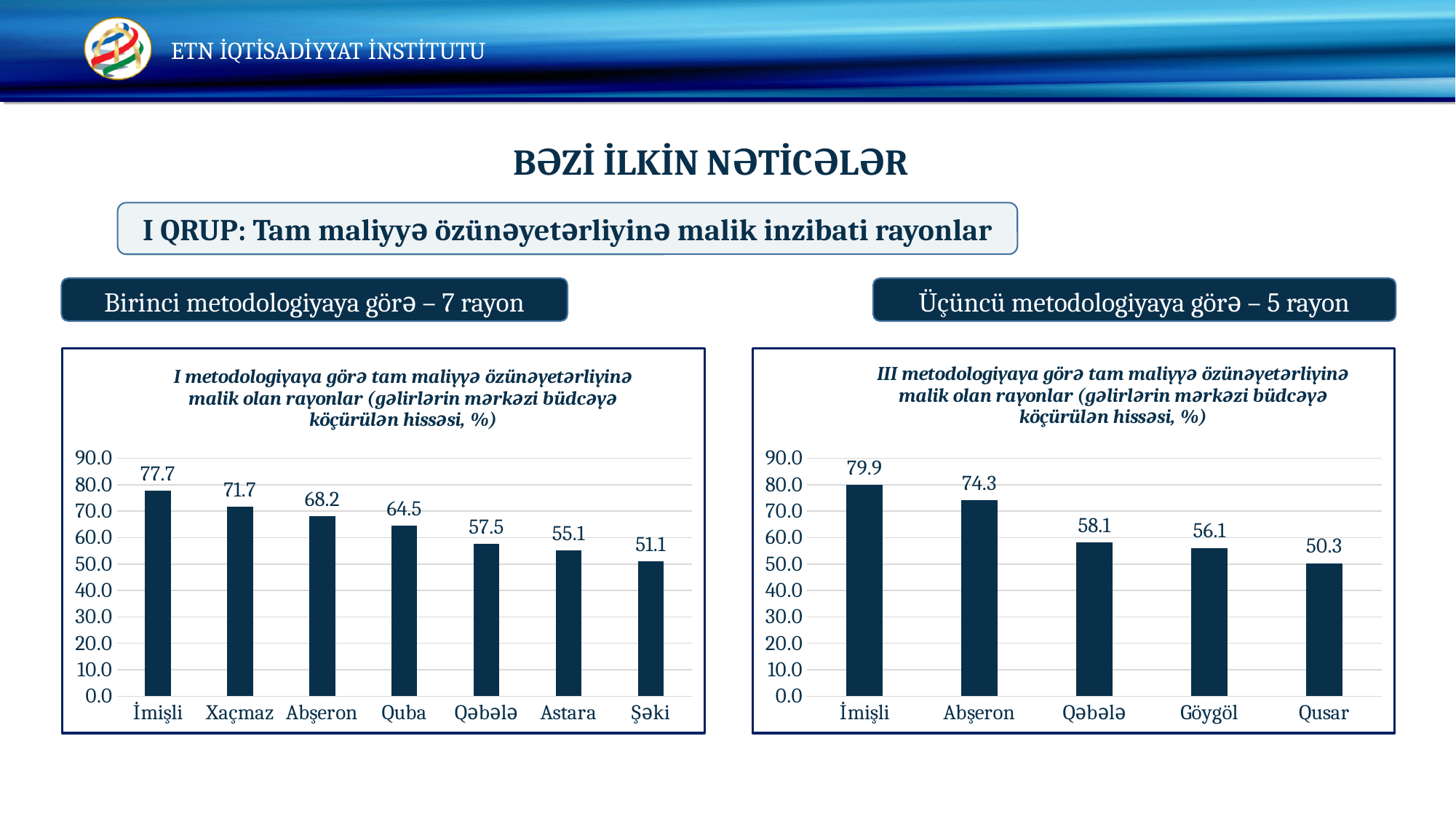
What kind of chart is the right chart (III metodologiyaya görə)? Bar chart How many rayons are shown in the right chart (III metodologiyaya görə)? 5 In the left chart (I metodologiyaya görə), what is the difference between the values for İmişli and Şəki? 26.6 In the right chart (III metodologiyaya görə), what is the difference between the values for Abşeron and Qəbələ? 16.2 How many rayons are shown in the left chart (I metodologiyaya görə)? 7 In the left chart (I metodologiyaya görə), which is larger, the value for Quba or the value for Astara? Quba In the left chart (I metodologiyaya görə), which rayon has the highest value? İmişli In the right chart (III metodologiyaya görə), is the value for Qəbələ greater or less than 60.0? less In the left chart (I metodologiyaya görə), do the values rise or fall from İmişli to Şəki? Fall In the left chart (I metodologiyaya görə), what is the value for Xaçmaz? 71.7 In the right chart (III metodologiyaya görə), what is the value for Göygöl? 56.1 In the right chart (III metodologiyaya görə), which rayon has the lowest value? Qusar